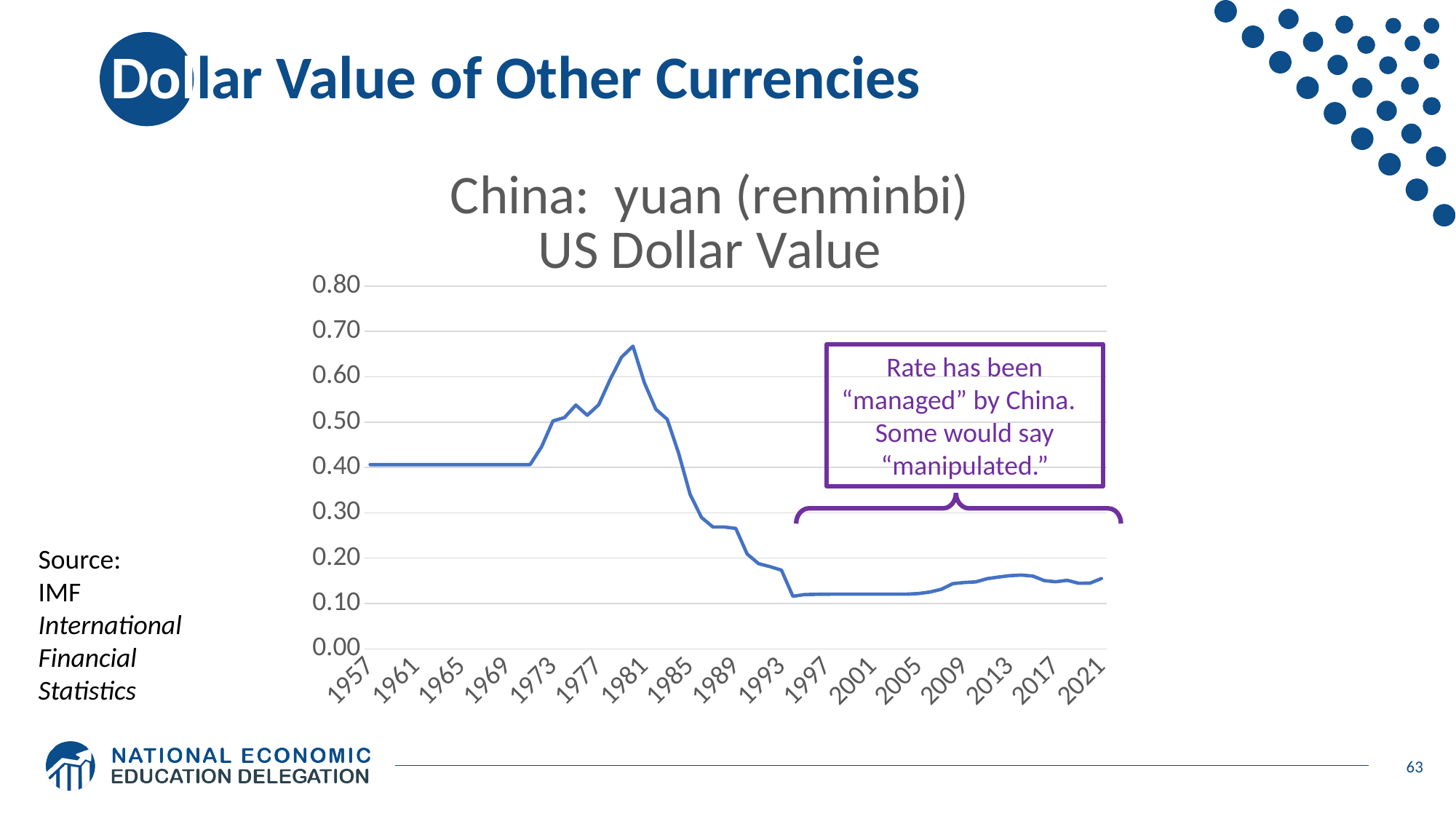
What kind of chart is shown on the slide? line chart Is the value for 1989 greater or less than 0.30? less How many year labels are shown on the x axis? 17 Is the peak value of the line greater or less than 0.60? greater Is the value for 2021 greater or less than 0.20? less Does the value rise or fall between 1981 and 1993? fall What is the title of the chart? China: yuan (renminbi) US Dollar Value Does the value rise or fall between 1969 and 1981? rise What is the highest value shown on the y axis? 0.80